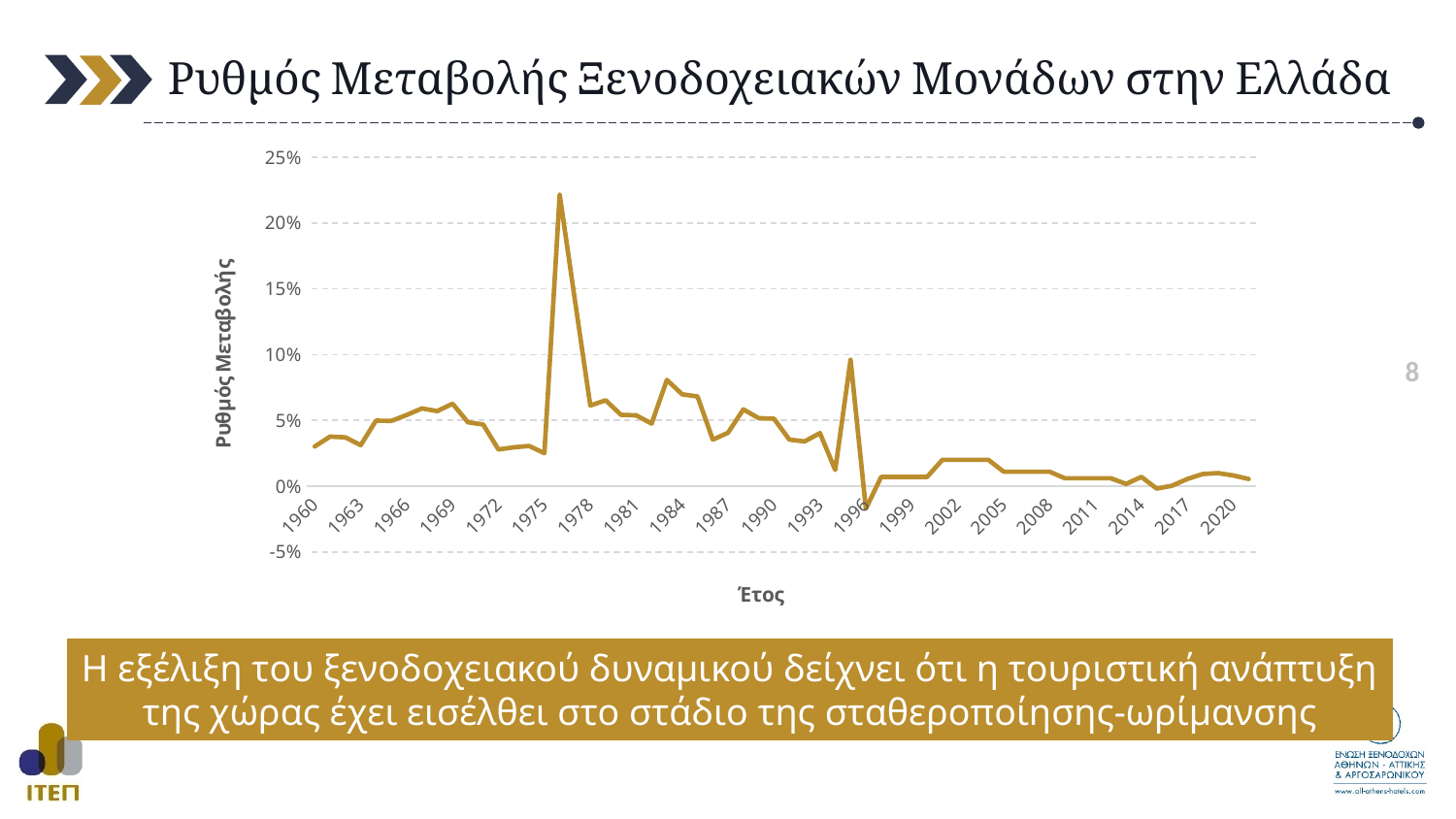
What is the title of the chart? Ρυθμός Μεταβολής Ξενοδοχειακών Μονάδων στην Ελλάδα Is the value for 2020 greater or less than 5%? less Which is larger, the value for 1969 or the value for 2008? 1969 Is the value for 1960 greater or less than 5%? less How many lines (series) are plotted on the chart? 1 Is the value for 1984 greater or less than 5%? greater What kind of chart is shown on the slide? Line chart What is the highest value shown on the y axis? 25% What is the label of the x axis? Έτος Overall, do the values rise or fall from 1960 to 2020? fall In which decade does the line reach its highest value? 1970s